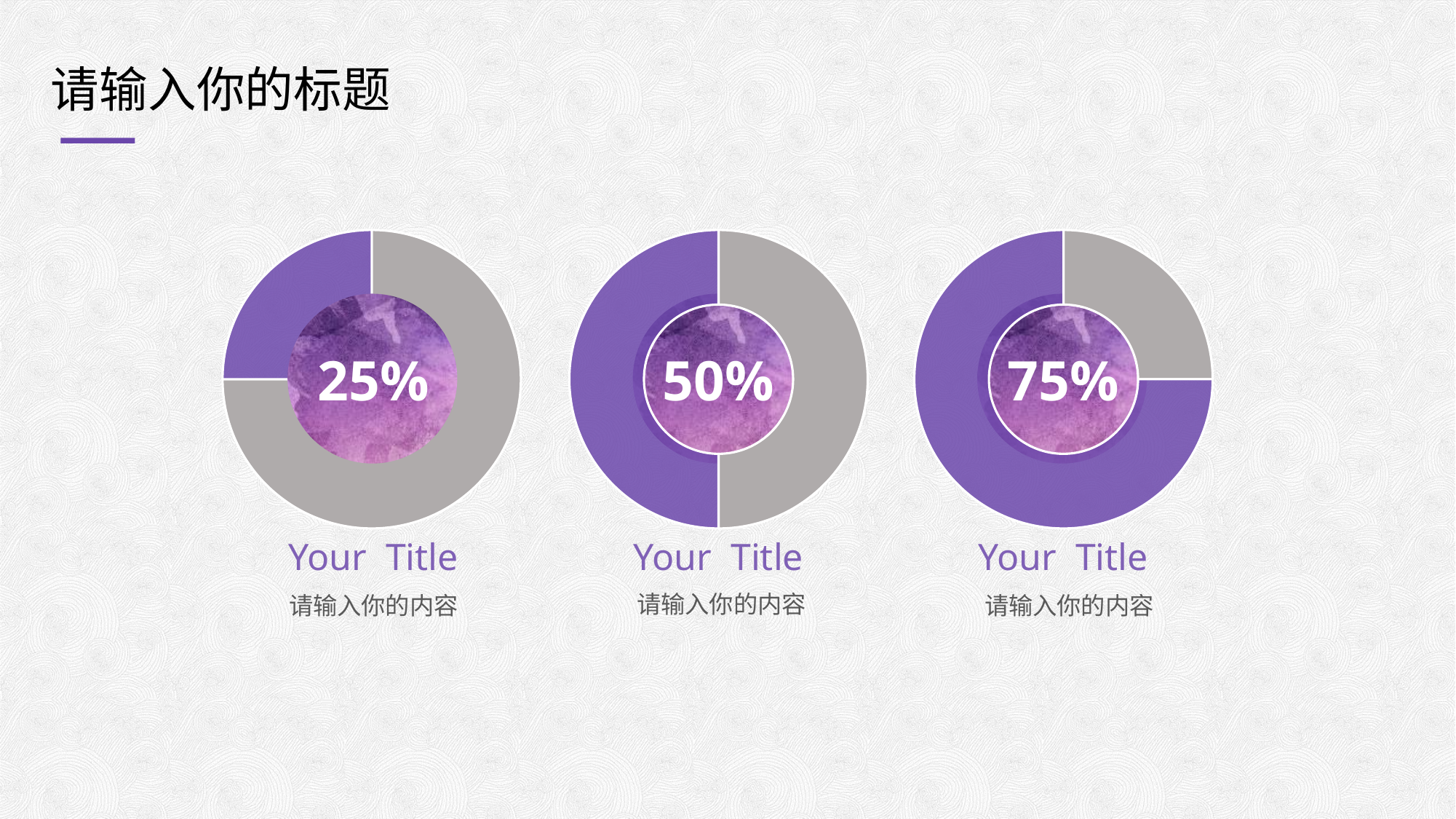
What percentage is shown in the centre of the left chart? 25% In the left chart, what share of the ring is grey (not filled)? 75% What percentage is shown in the centre of the right chart? 75% What percentage is shown in the centre of the middle chart? 50% In the right chart, what share of the ring is filled in purple? 75% What colour is used for the filled portion of each ring? Purple How many charts are shown on the slide? 3 Which chart shows the lowest percentage: the left, middle or right one? Left What is the difference between the percentage in the right chart and the percentage in the left chart? 50% What kind of chart is used for each of the three figures on the slide? Pie chart (donut) Which chart shows the highest percentage: the left, middle or right one? Right Which is larger, the percentage in the middle chart or the percentage in the left chart? Middle chart